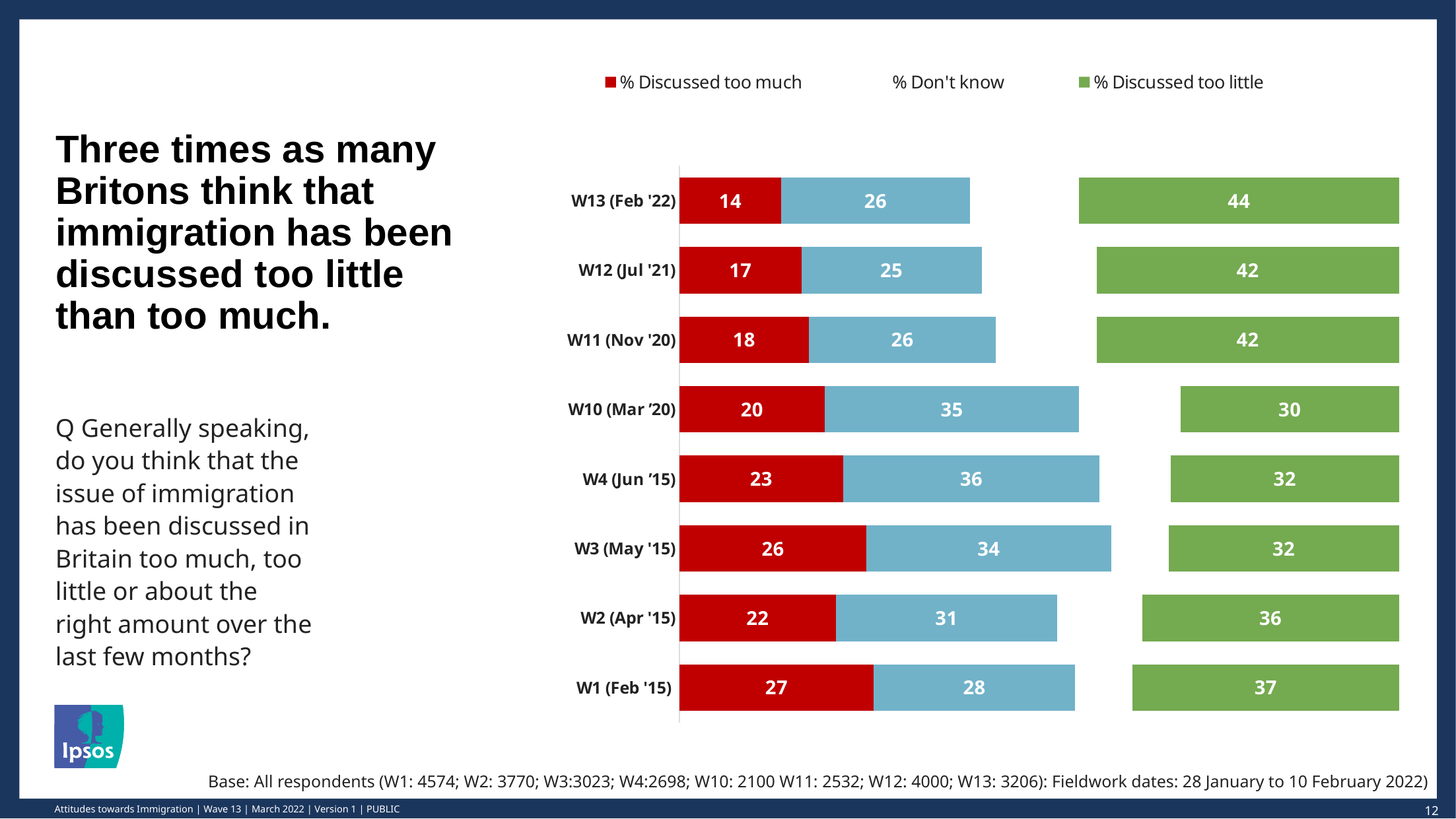
How many waves are shown on the chart? 8 Which wave has the highest '% Discussed too little' value? W13 (Feb '22) What colour represents '% Discussed too little' in the chart? Green Which wave has the lowest '% Discussed too much' value? W13 (Feb '22) What is the '% Discussed too much' value for W1 (Feb '15)? 27 What kind of chart is shown on the slide? Bar chart What percentage said immigration was discussed too little in W13 (Feb '22)? 44 How many series does the legend list? 3 What is the difference between '% Discussed too little' and '% Discussed too much' for W13 (Feb '22)? 30